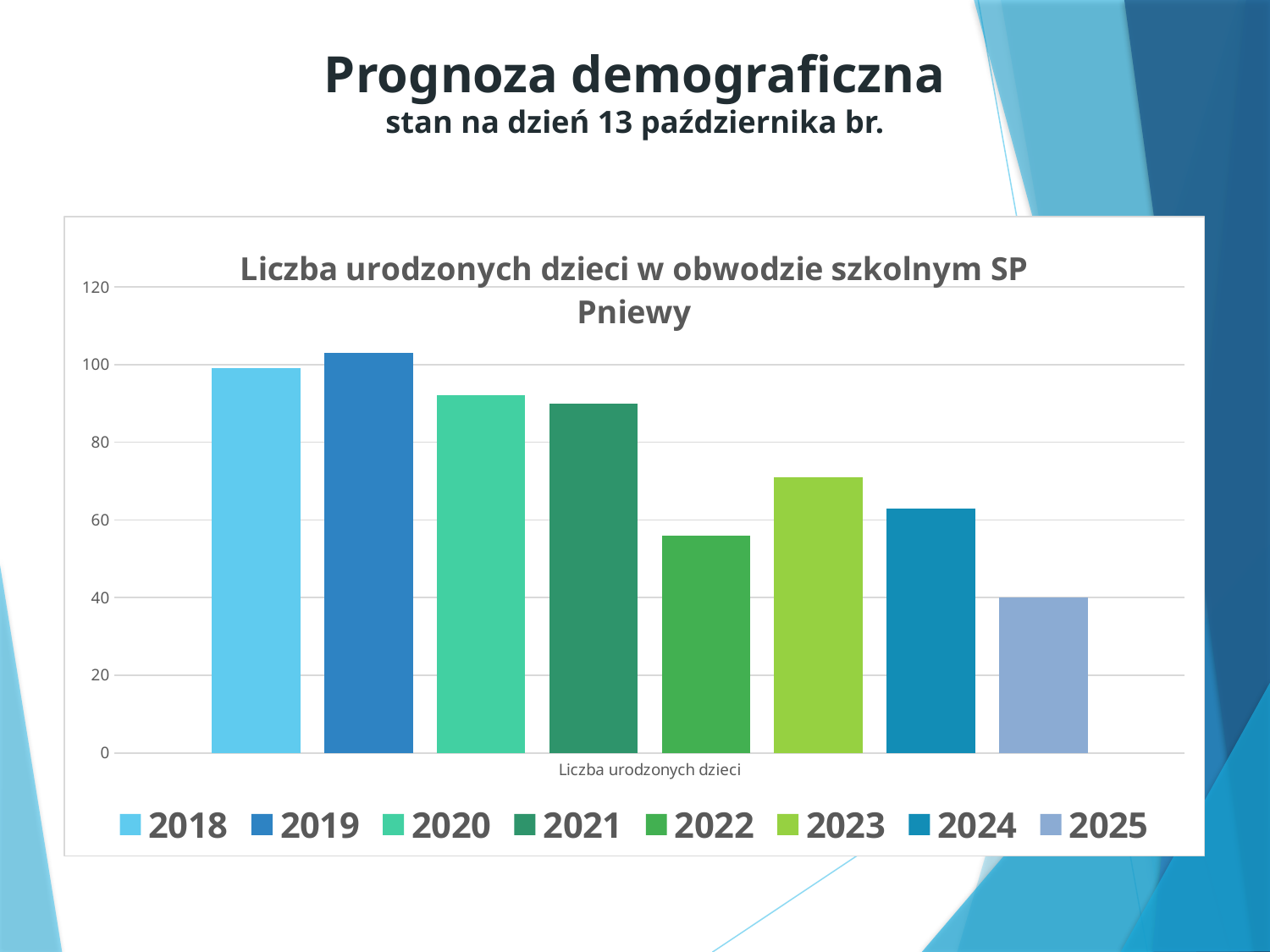
What kind of chart is shown on the slide? bar chart Which year has the highest number of children born? 2019 What is the title of the chart? Liczba urodzonych dzieci w obwodzie szkolnym SP Pniewy Is the value for 2021 greater or less than 80? greater Which year has the lowest number of children born? 2025 How many series does the legend list? 8 Is the value for 2022 greater or less than 60? less Which is larger, the value for 2023 or the value for 2024? 2023 Is the value for 2023 greater or less than 60? greater Which is larger, the value for 2022 or the value for 2024? 2024